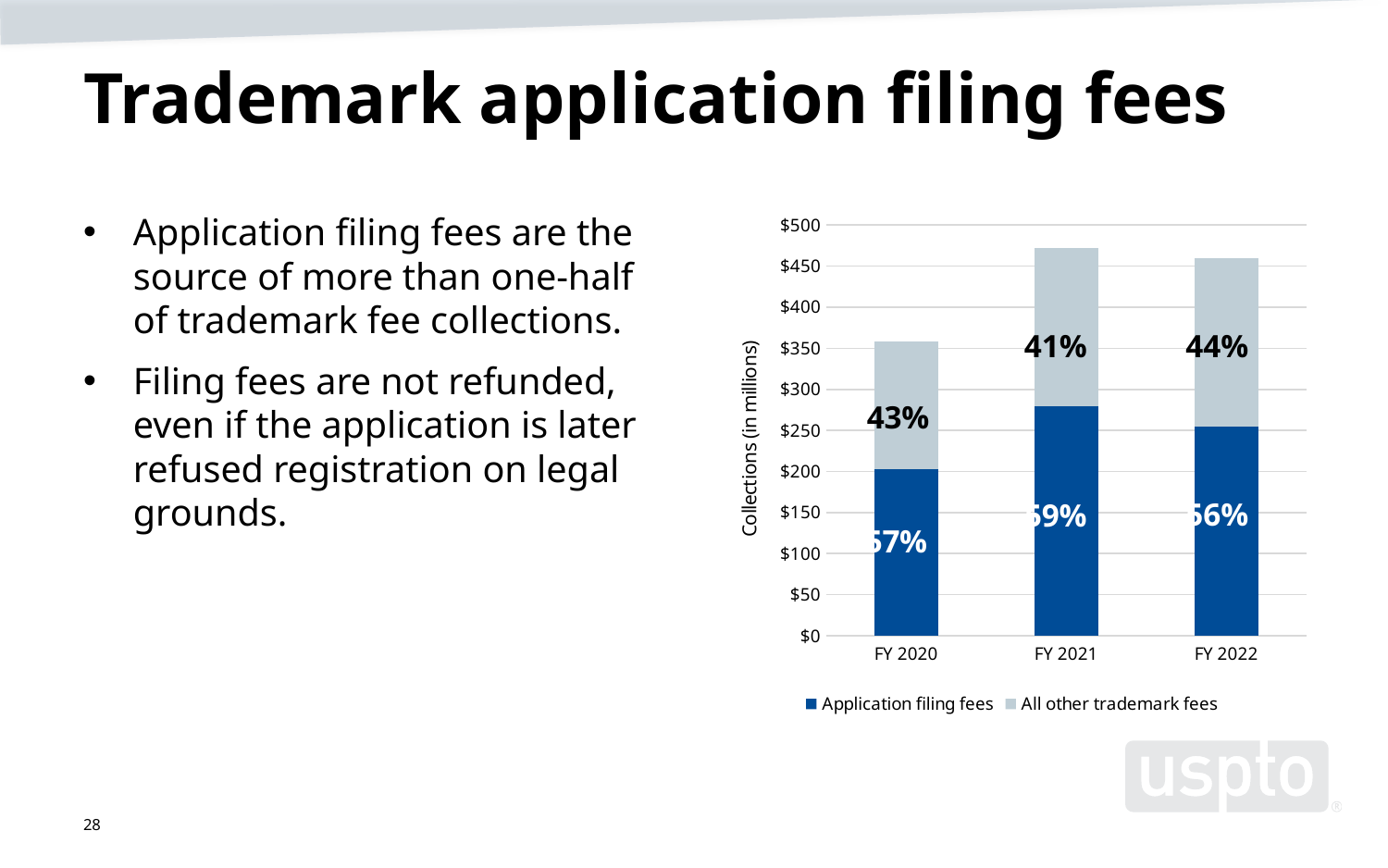
Is the Application filing fees segment for FY 2021 greater or less than $250? greater What percentage label is shown for Application filing fees in FY 2020? 57% What percentage label is shown for Application filing fees in FY 2021? 59% What kind of chart is shown on the slide? Stacked bar chart Which fiscal year has the lowest total collections bar? FY 2020 How many series does the chart's legend list? 2 How many fiscal years are shown on the x axis of the chart? 3 What percentage label is shown for All other trademark fees in FY 2021? 41% Is the total collections bar for FY 2021 greater or less than $450? greater What percentage label is shown for All other trademark fees in FY 2022? 44% In FY 2020, what is the difference in percentage points between the Application filing fees label and the All other trademark fees label? 14 What is the title of the chart's vertical axis? Collections (in millions)